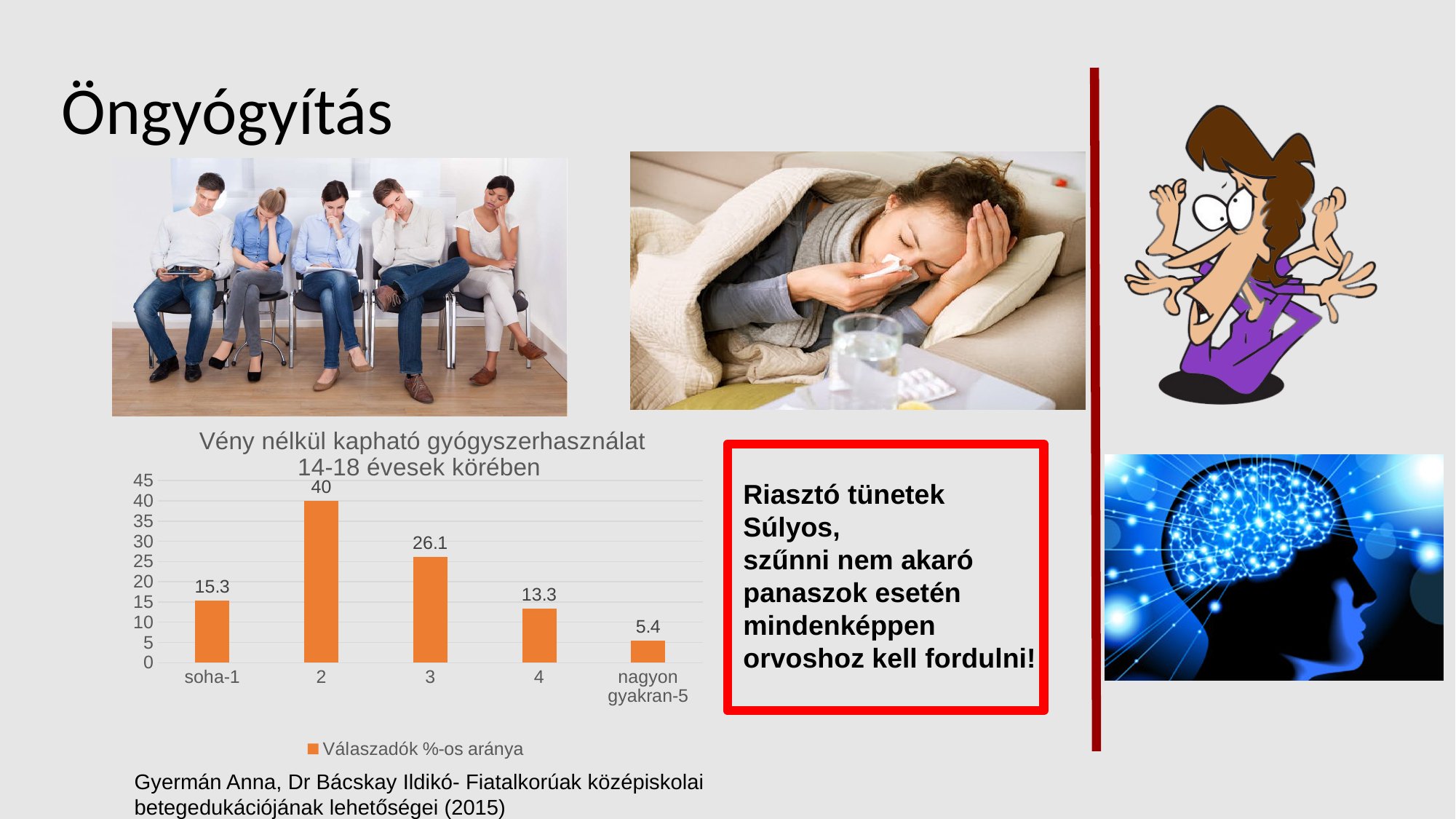
What is the value for 'nagyon gyakran-5' in the chart? 5.4 Which category has the highest value in the chart? 2 What is the value for 'soha-1' in the chart? 15.3 How many categories are shown in the chart? 5 Is the value for category 3 greater or less than 25? greater Which is larger, the value for 'soha-1' or the value for category 4? soha-1 What kind of chart is shown on the slide? bar chart What is the value for category 2 in the chart? 40 What is the legend entry of the chart? Válaszadók %-os aránya What is the difference between the values for category 2 and category 3? 13.9 What is the value for category 4 in the chart? 13.3 Which category has the lowest value in the chart? nagyon gyakran-5